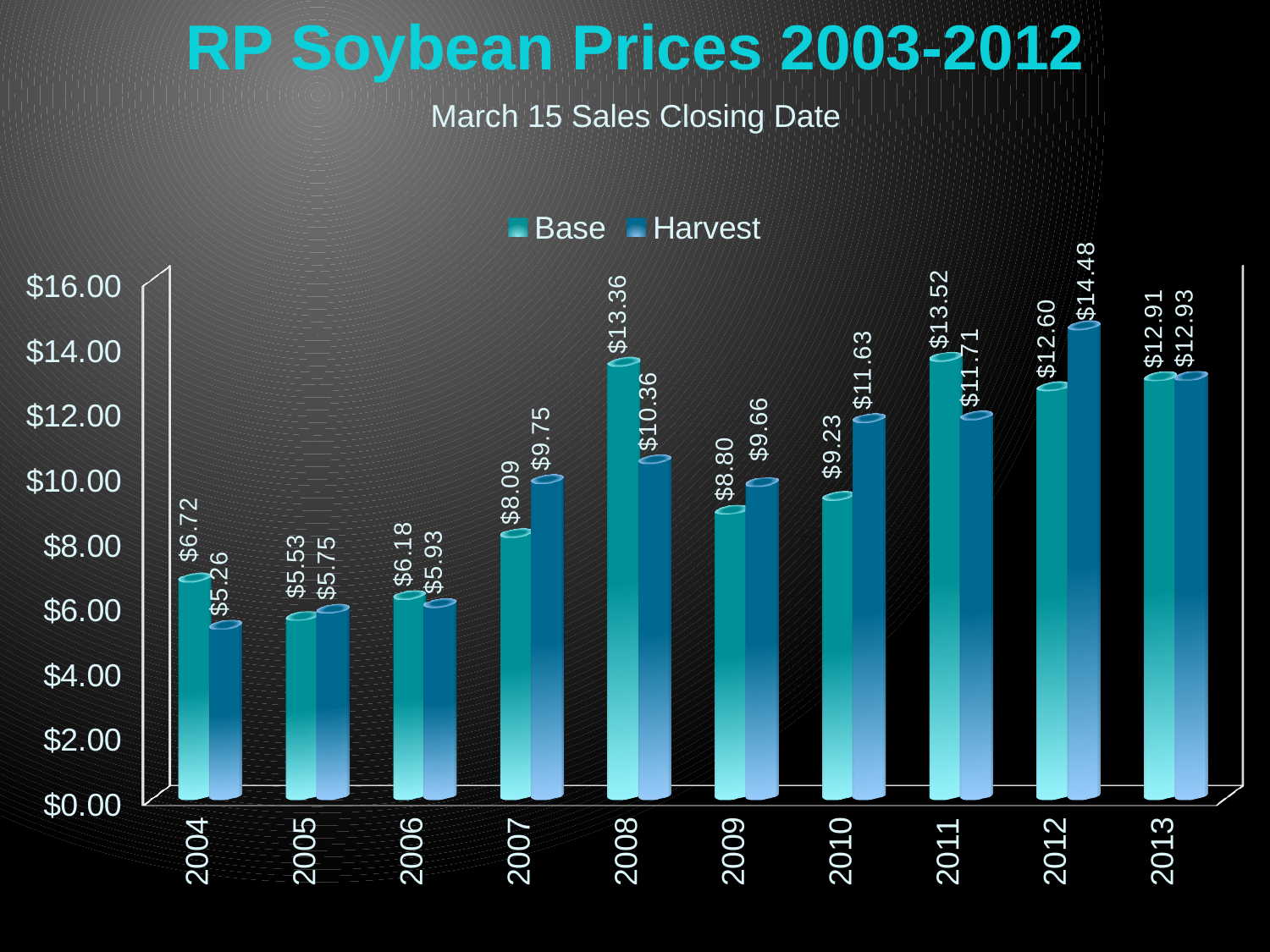
What is the difference between the Base and Harvest prices in 2008? $3.00 How many years are shown on the x axis? 10 Which year has the highest Base price? 2011 What kind of chart is shown on the slide? Bar chart What is the Base price for 2008? $13.36 Which year has the highest Harvest price? 2012 What is the Harvest price for 2010? $11.63 Which year has the lowest Harvest price? 2004 What is the difference between the Harvest and Base prices in 2012? $1.88 How many series does the legend list? 2 What is the Base price for 2005? $5.53 In 2008, which is larger, the Base price or the Harvest price? Base